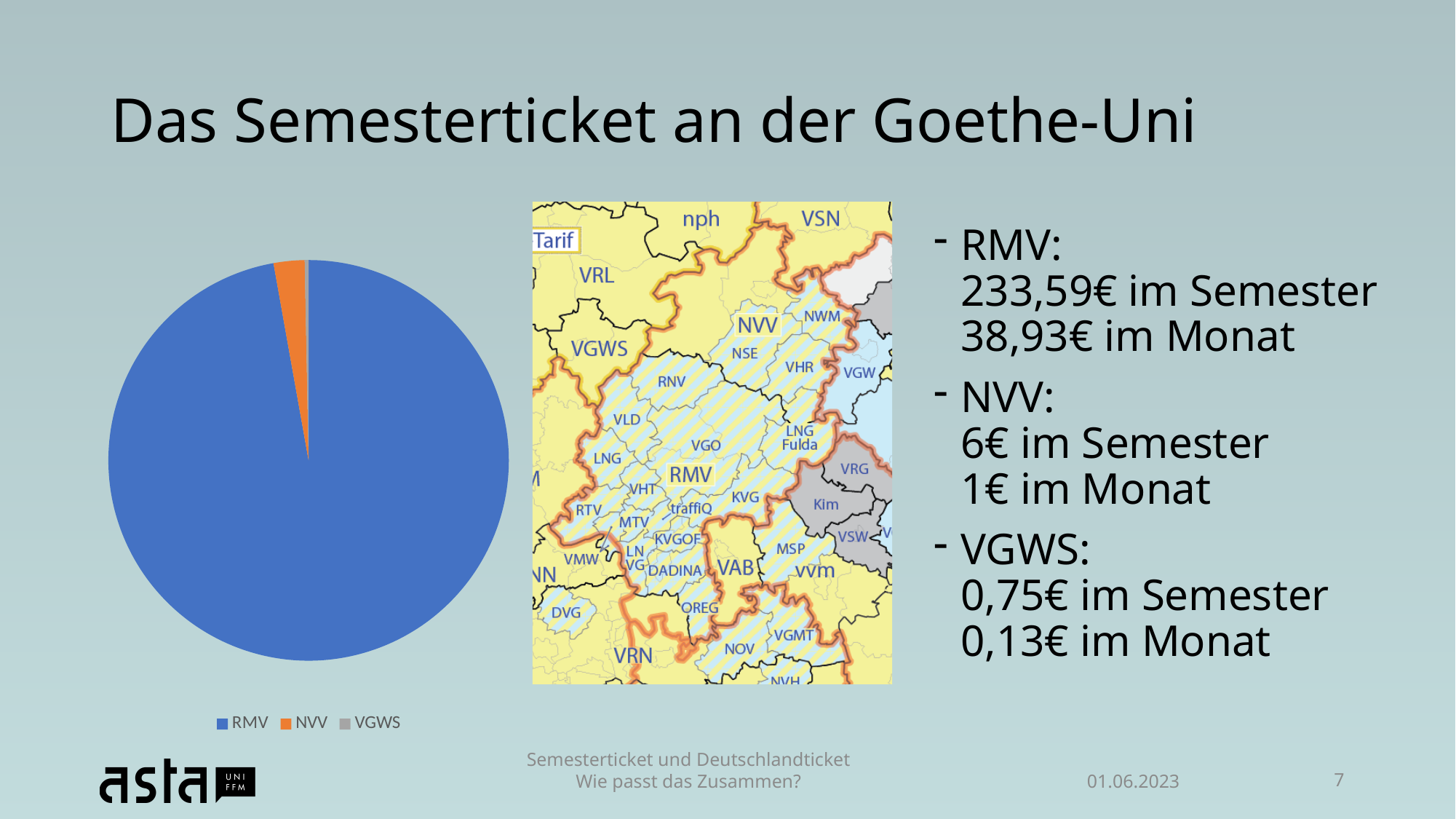
In the pie chart, which slice is larger, NVV or VGWS? NVV What colour is the NVV slice in the pie chart? orange How many slices does the pie chart have? 3 Which category has the smallest slice in the pie chart? VGWS What kind of chart is shown on the left of the slide? pie chart How many entries does the legend of the pie chart list? 3 Which category has the largest slice in the pie chart? RMV In the pie chart, which slice is larger, RMV or NVV? RMV What colour is the RMV slice in the pie chart? blue